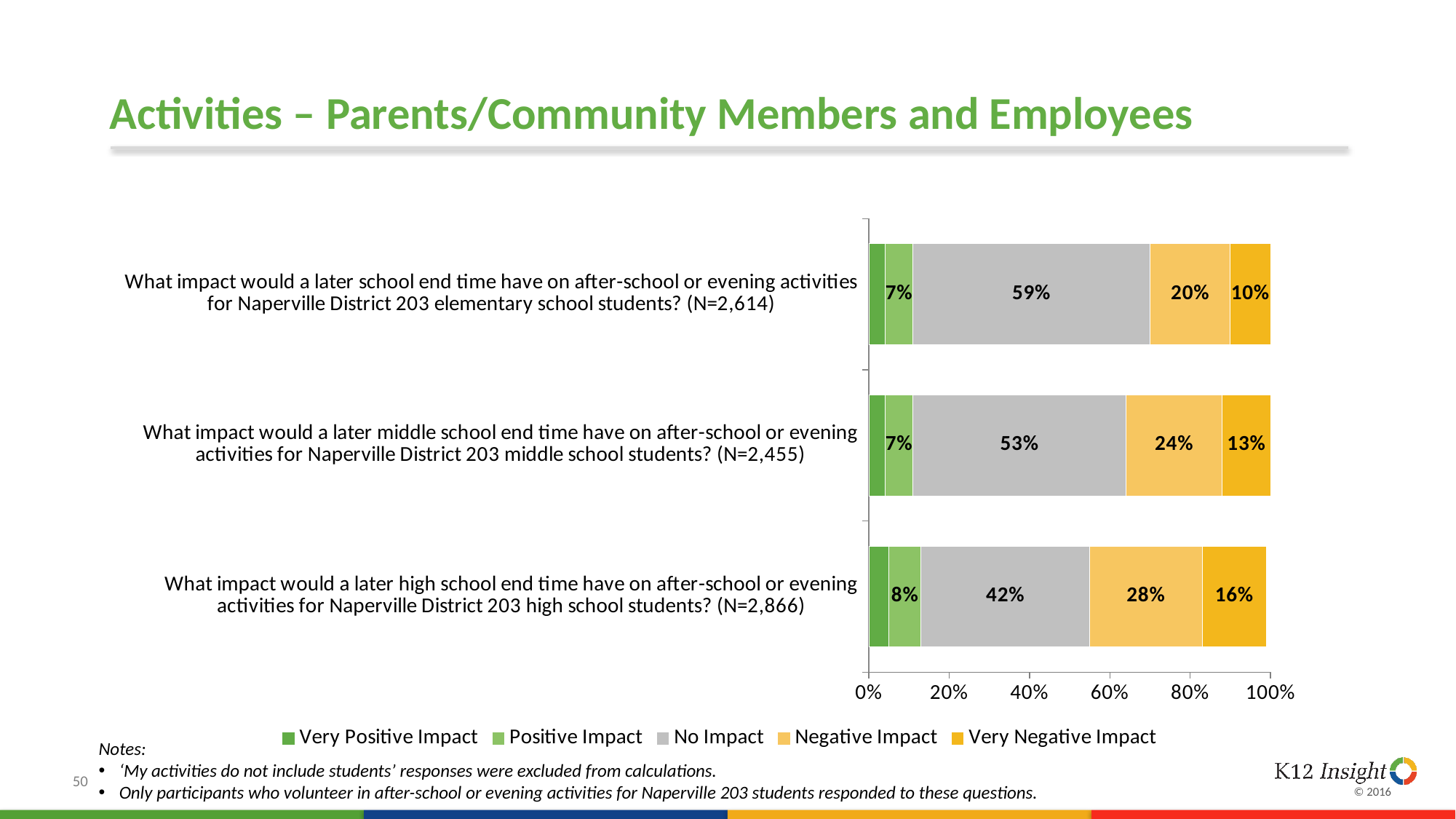
What is the Negative Impact percentage for the middle school question? 24% What is the Positive Impact percentage for the high school question? 8% What is the difference between the No Impact percentages for the elementary school and high school questions? 17% Which question has the highest No Impact percentage? The elementary school question Which question has the lowest Very Negative Impact percentage? The elementary school question Is the Negative Impact percentage larger for the middle school question or the high school question? The high school question Which legend entry is shown in grey? No Impact What is the Very Negative Impact percentage for the high school question? 16% What kind of chart is shown on the slide? Stacked bar chart What is the No Impact percentage for the elementary school question? 59% How many series does the legend list? 5 How many survey questions (bars) are plotted in the chart? 3